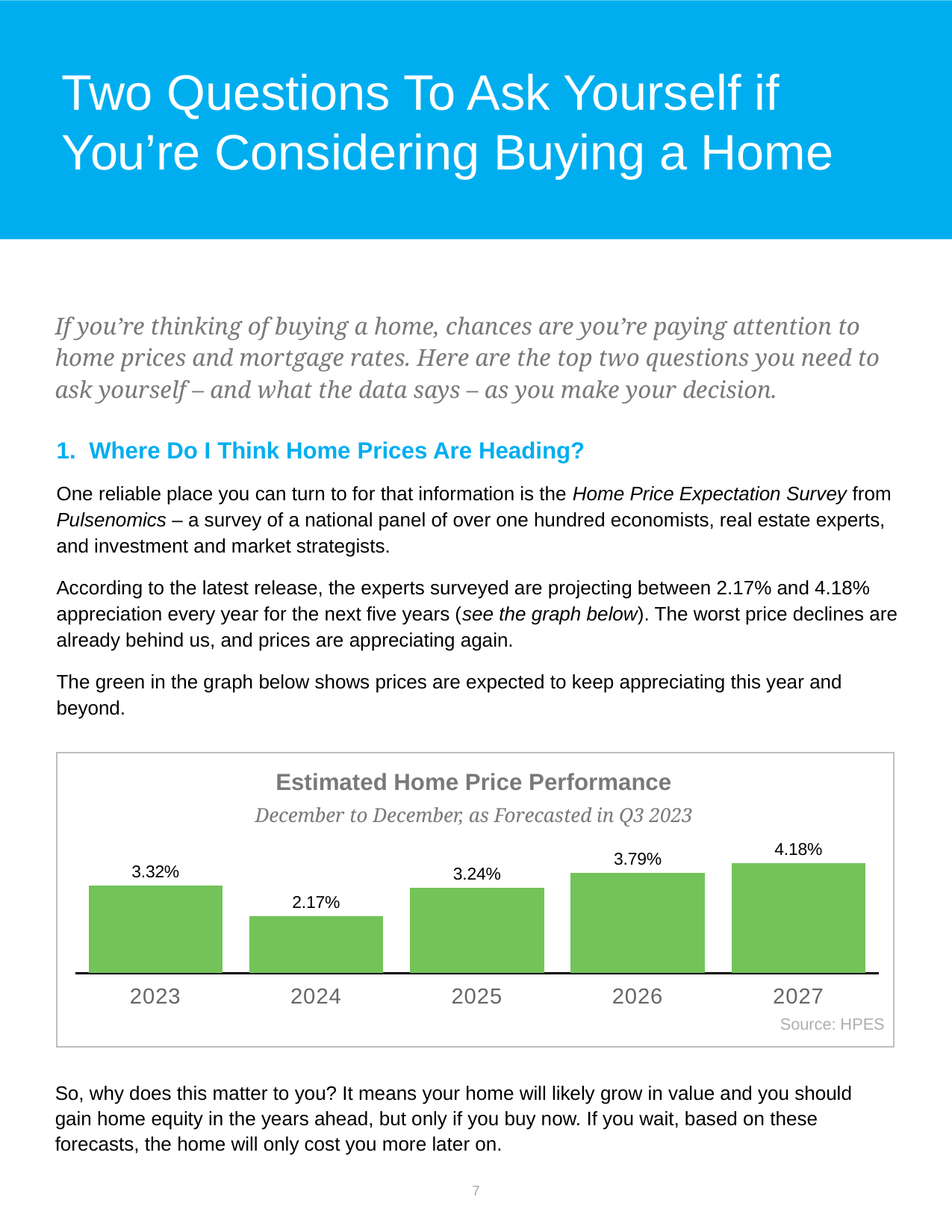
What is the difference between the estimated home price performance for 2027 and 2024? 2.01% Which year has the lowest estimated home price performance? 2024 What is the title of the chart? Estimated Home Price Performance Do the values rise or fall from 2024 to 2027? Rise What is the difference between the estimated home price performance for 2023 and 2025? 0.08% How many years are shown in the chart? 5 What is the estimated home price performance for 2024? 2.17% What is the estimated home price performance for 2023? 3.32% What is the estimated home price performance for 2026? 3.79% Which year has a larger estimated home price performance, 2025 or 2026? 2026 Which year has the highest estimated home price performance? 2027 What kind of chart is shown on the slide? Bar chart